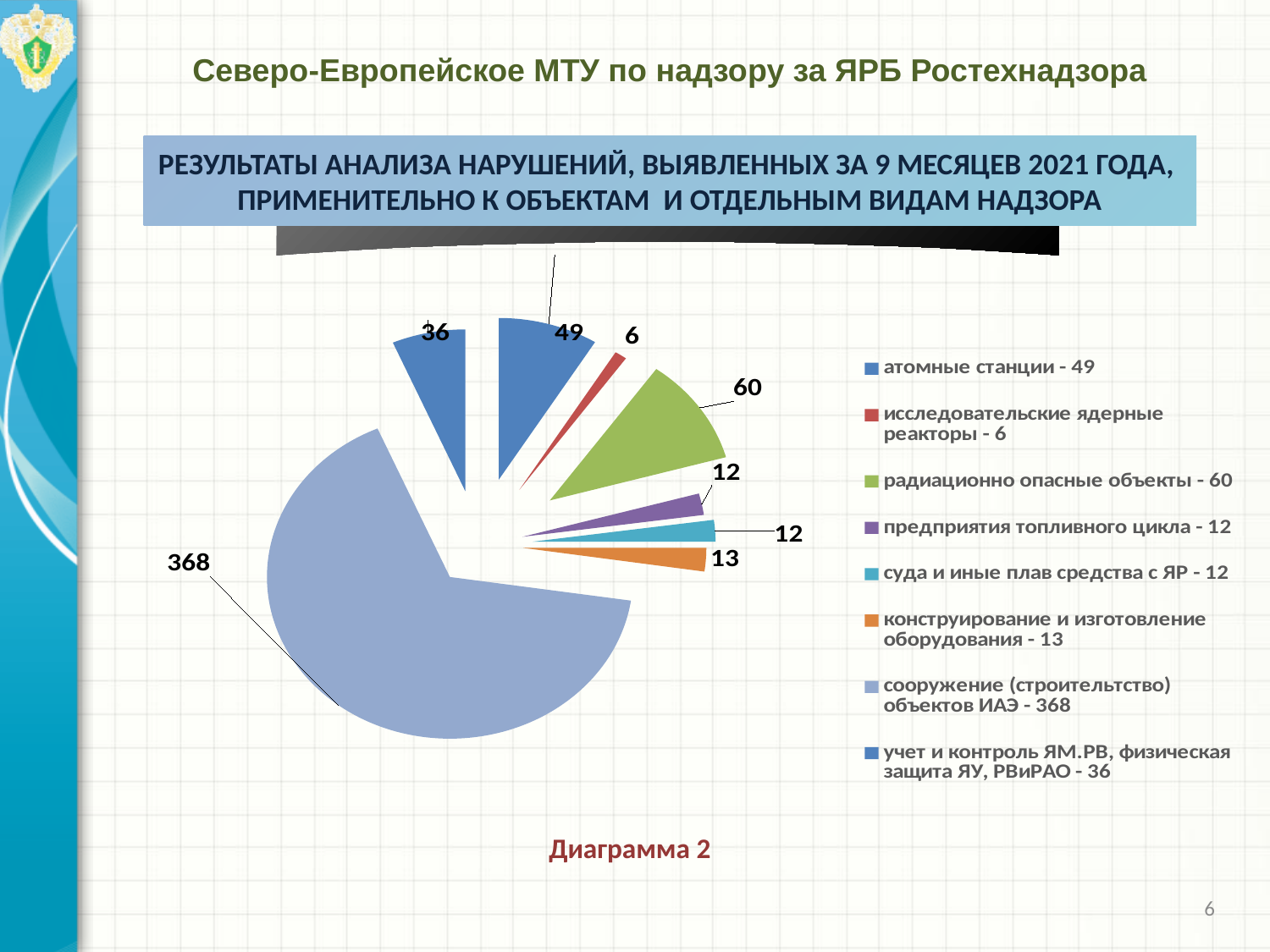
How many slices does the pie chart have? 8 Which category has the largest slice of the pie? сооружение (строительство) объектов ИАЭ - 368 What is the total of all values shown in the pie chart? 556 What type of chart is shown on the slide? pie chart Which category has the smallest slice of the pie? исследовательские ядерные реакторы - 6 What is the difference between the values for "радиационно опасные объекты" and "атомные станции"? 11 What is the value for "радиационно опасные объекты"? 60 What is the caption written below the chart? Диаграмма 2 What is the value for "сооружение (строительство) объектов ИАЭ"? 368 What is the value for "атомные станции"? 49 Which is larger: the value for "учет и контроль ЯМ.РВ, физическая защита ЯУ, РВиРАО" or the value for "конструирование и изготовление оборудования"? учет и контроль ЯМ.РВ, физическая защита ЯУ, РВиРАО